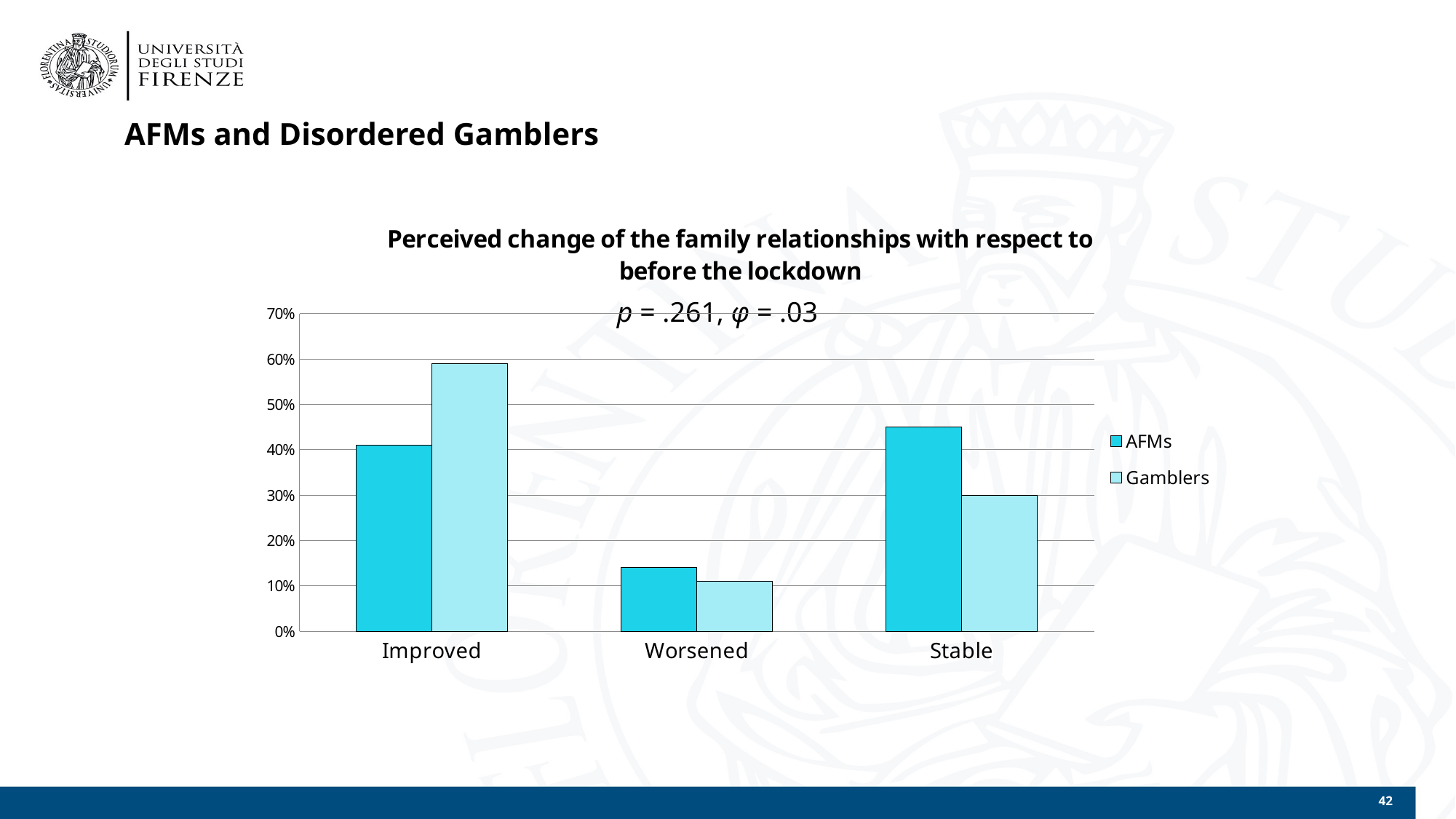
For the Improved category, which series has the larger value, AFMs or Gamblers? Gamblers Is the value for AFMs in the Worsened category greater or less than 20%? less How many categories are shown on the x axis? 3 Which category has the highest value for AFMs? Stable What are the two series named in the legend? AFMs and Gamblers Is the value for AFMs in the Stable category greater or less than 40%? greater Which category has the lowest value for AFMs? Worsened Which category has the highest value for Gamblers? Improved How many series does the legend list? 2 Is the value for Gamblers in the Improved category greater or less than 50%? greater For the Stable category, which series has the larger value, AFMs or Gamblers? AFMs What kind of chart is shown on the slide? bar chart